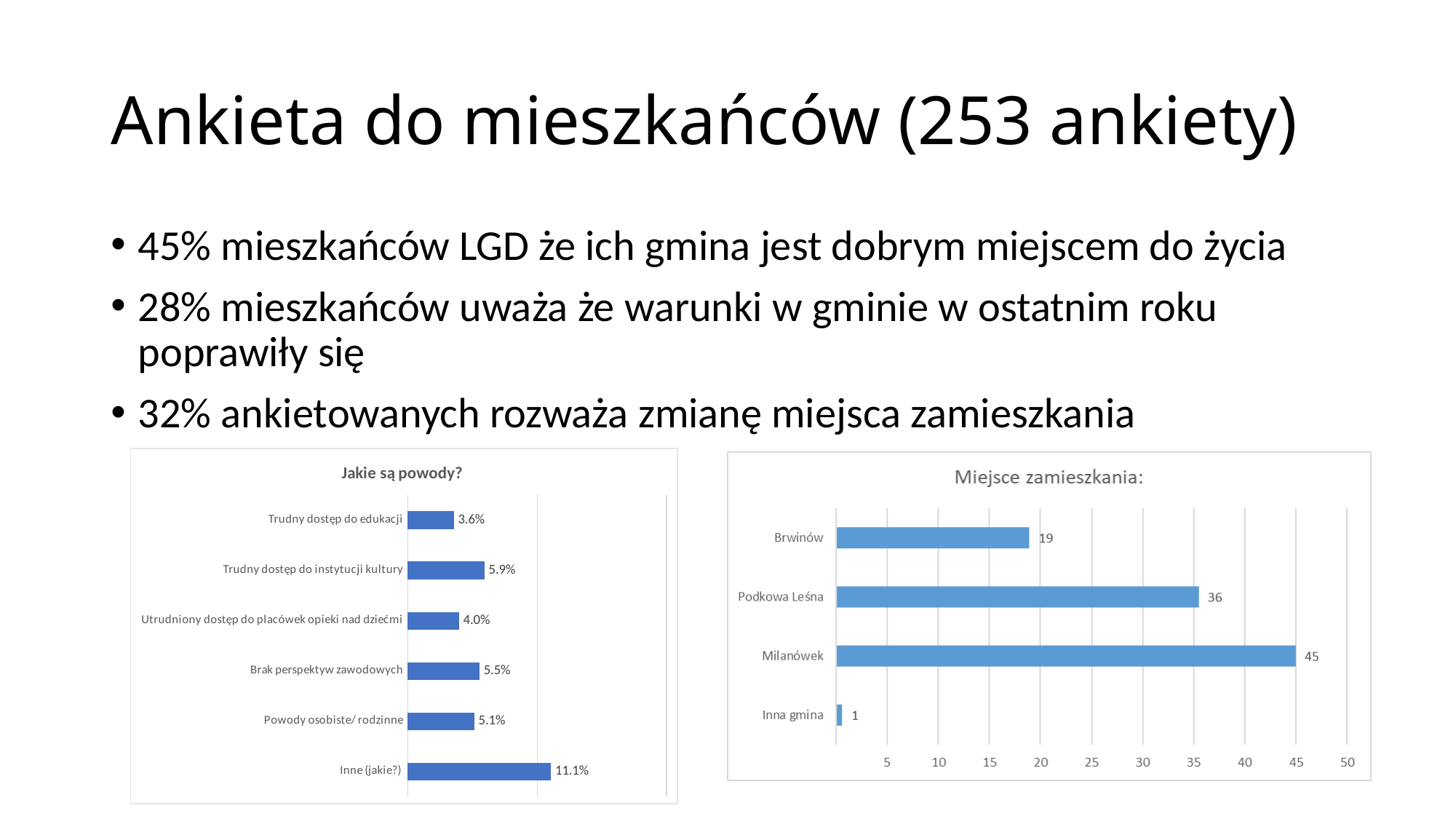
In the 'Jakie są powody?' chart, what is the value for 'Powody osobiste/ rodzinne'? 5.1% In the 'Jakie są powody?' chart, which category has the highest value? Inne (jakie?) In the 'Miejsce zamieszkania:' chart, which category has the highest value? Milanówek In the 'Miejsce zamieszkania:' chart, which is larger, Brwinów or Podkowa Leśna? Podkowa Leśna In the 'Miejsce zamieszkania:' chart, what is the value for Podkowa Leśna? 36 In the 'Jakie są powody?' chart, what is the value for 'Trudny dostęp do edukacji'? 3.6% In the 'Miejsce zamieszkania:' chart, what is the difference between Milanówek and Brwinów? 26 In the 'Jakie są powody?' chart, how many categories are shown? 6 In the 'Miejsce zamieszkania:' chart, which category has the lowest value? Inna gmina In the 'Jakie są powody?' chart, what is the difference between 'Trudny dostęp do instytucji kultury' and 'Brak perspektyw zawodowych'? 0.4% What type of chart is the 'Miejsce zamieszkania:' chart? Bar chart In the 'Jakie są powody?' chart, which category has the lowest value? Trudny dostęp do edukacji